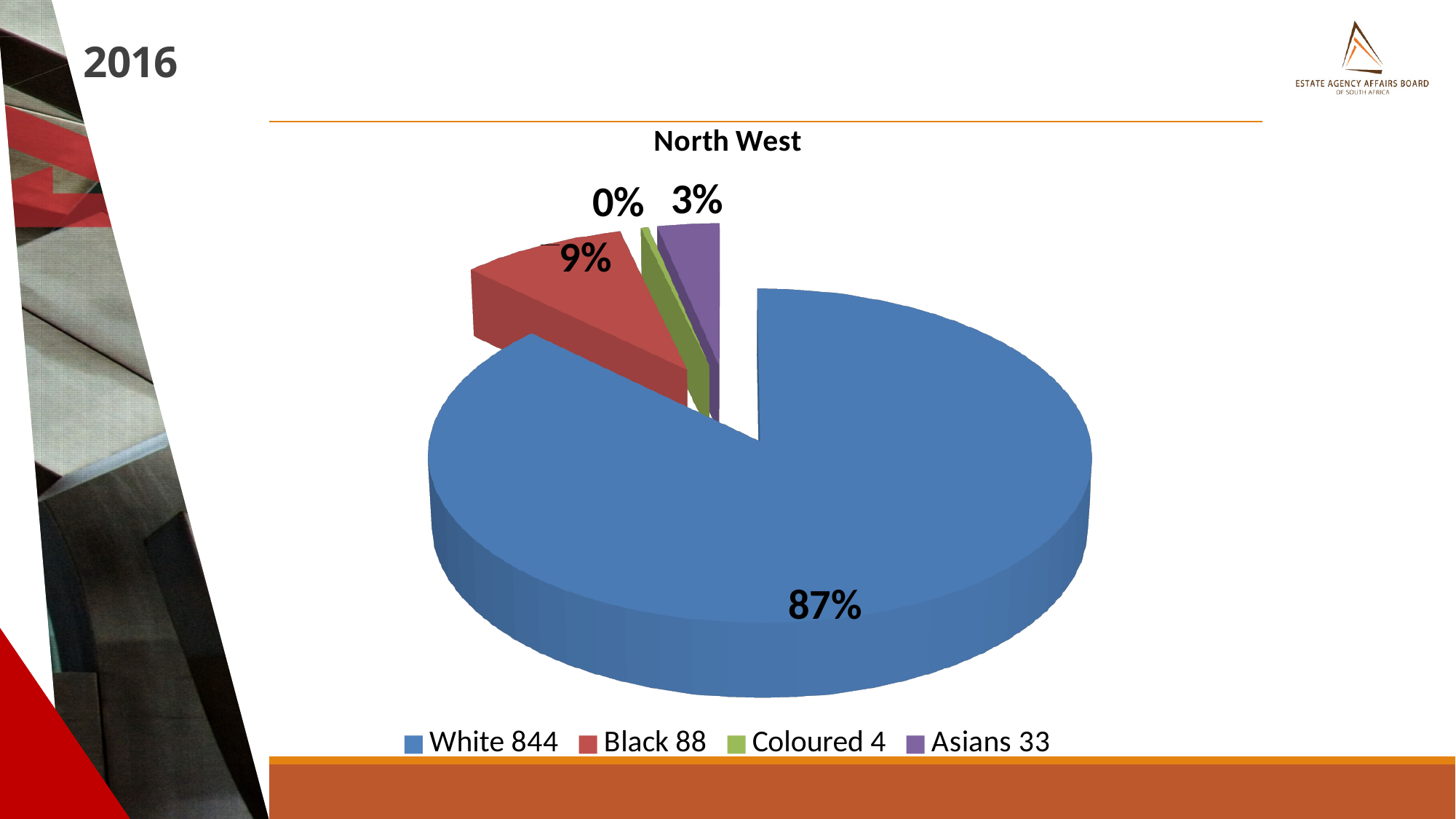
What share of the pie does Coloured represent? 0% What is the difference between the counts for Black and Asians? 55 What share of the pie does Black represent? 9% What is the count shown in the legend for White? 844 Which category has the smallest slice of the pie? Coloured Which category has the largest slice of the pie? White How many categories does the pie chart show? 4 What is the count shown in the legend for Asians? 33 What share of the pie does Asians represent? 3% What type of chart is shown on the slide? Pie chart What is the title of the chart? North West